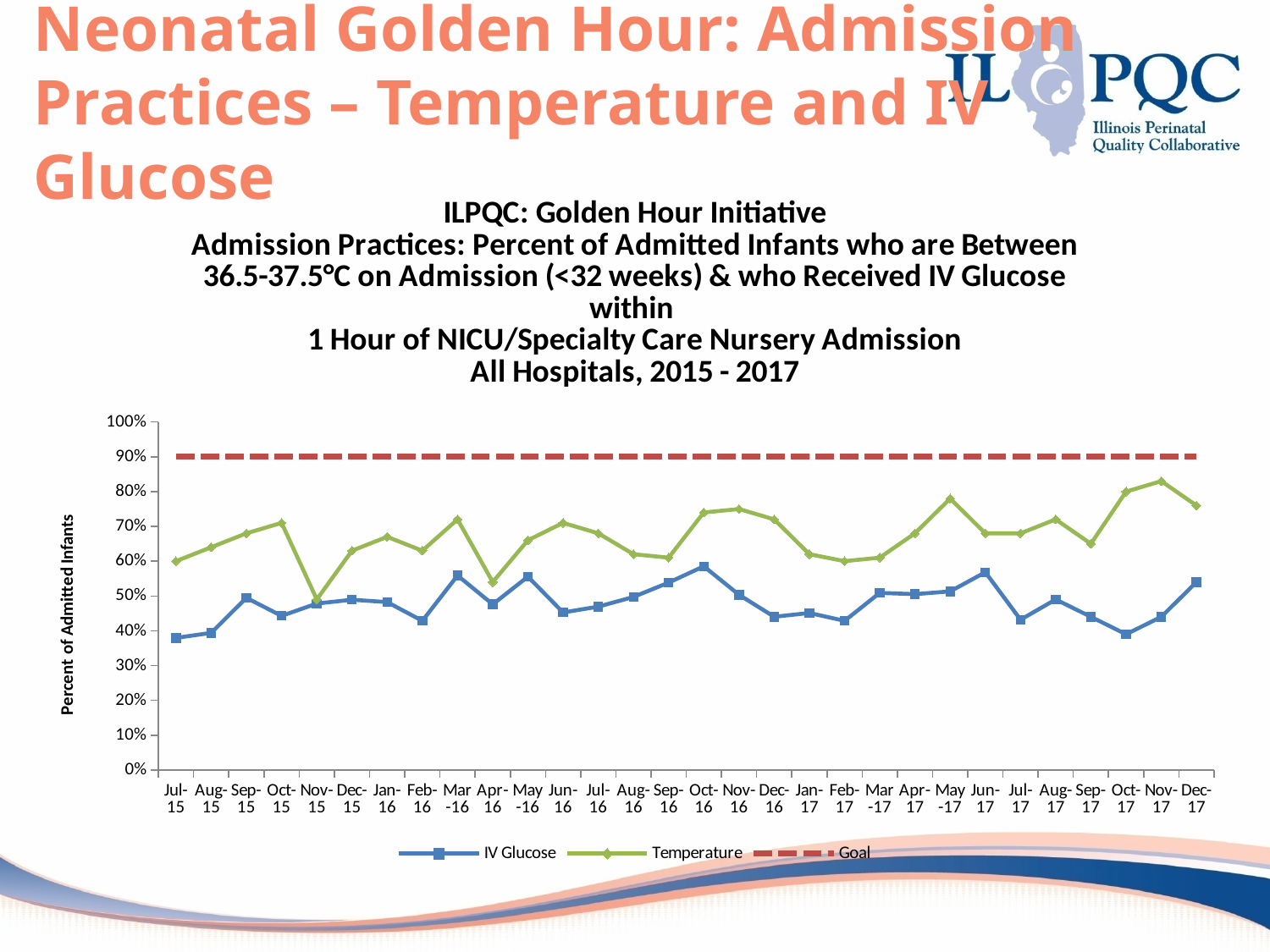
In which month is the Temperature series at its lowest? Nov-15 Is the Temperature value for Nov-15 greater or less than 60%? less Does the Temperature series rise or fall from Jul-15 to Oct-15? rise In Jul-15, which series has the higher value, IV Glucose or Temperature? Temperature What kind of chart is shown on the slide? line chart What value does the Goal line sit at? 90% Is the IV Glucose value for Oct-16 greater or less than 50%? greater What is the label on the y axis? Percent of Admitted Infants How many series does the legend list? 3 Is the Temperature value for Nov-17 greater or less than 70%? greater Which is larger for IV Glucose, the value in Oct-16 or the value in Jul-17? Oct-16 How many months are plotted along the x axis? 30